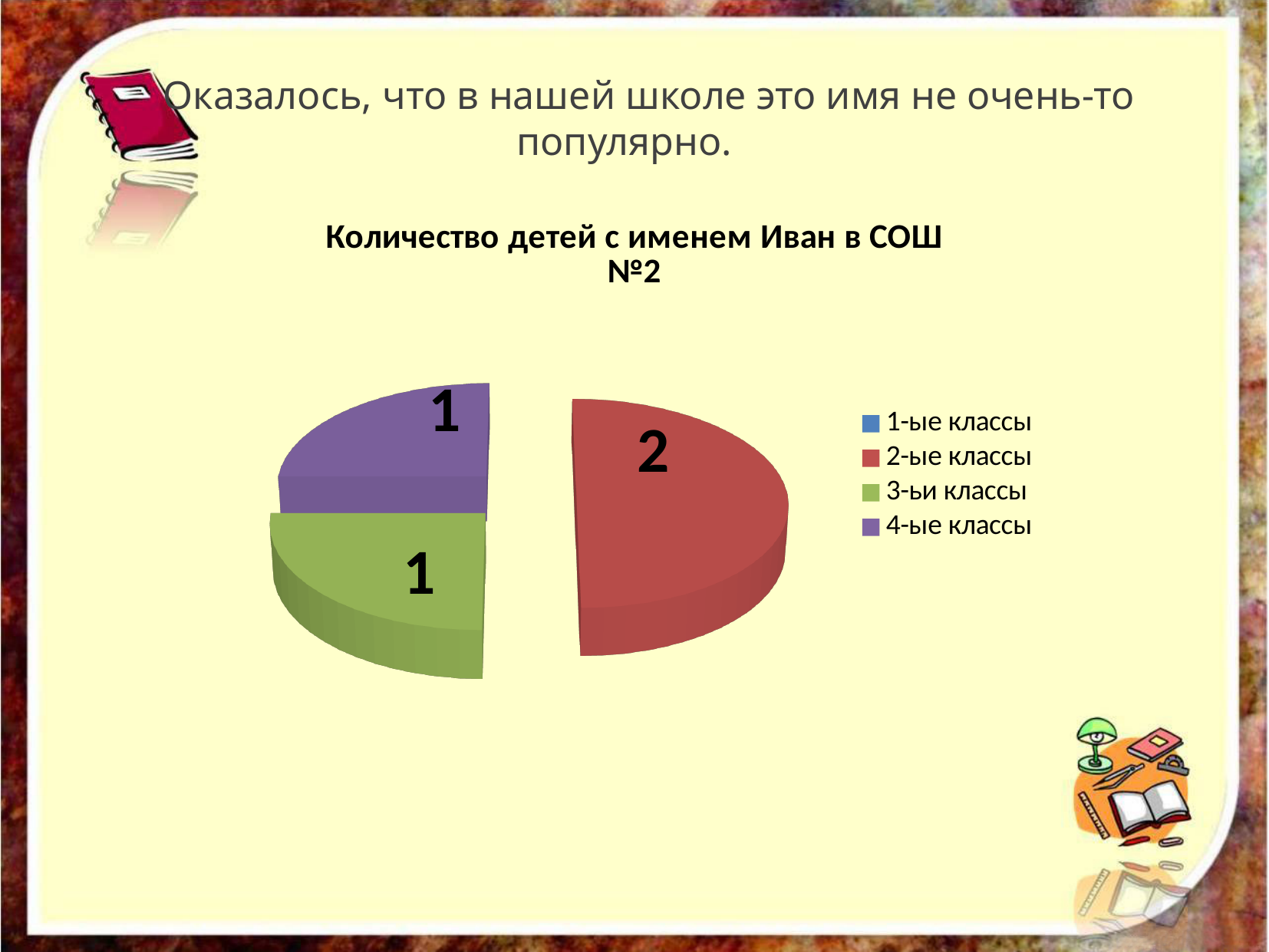
What is the title of the chart? Количество детей с именем Иван в СОШ №2 What is the difference between the value for 2-ые классы and the value for 3-ьи классы? 1 Which category has the largest slice in the pie chart? 2-ые классы What is the value shown for 2-ые классы? 2 What colour represents 2-ые классы in the chart? red How many entries does the chart legend list? 4 What is the value shown for 4-ые классы? 1 What is the value shown for 3-ьи классы? 1 What type of chart is shown on the slide? pie chart Which is larger, the value for 2-ые классы or the value for 4-ые классы? 2-ые классы